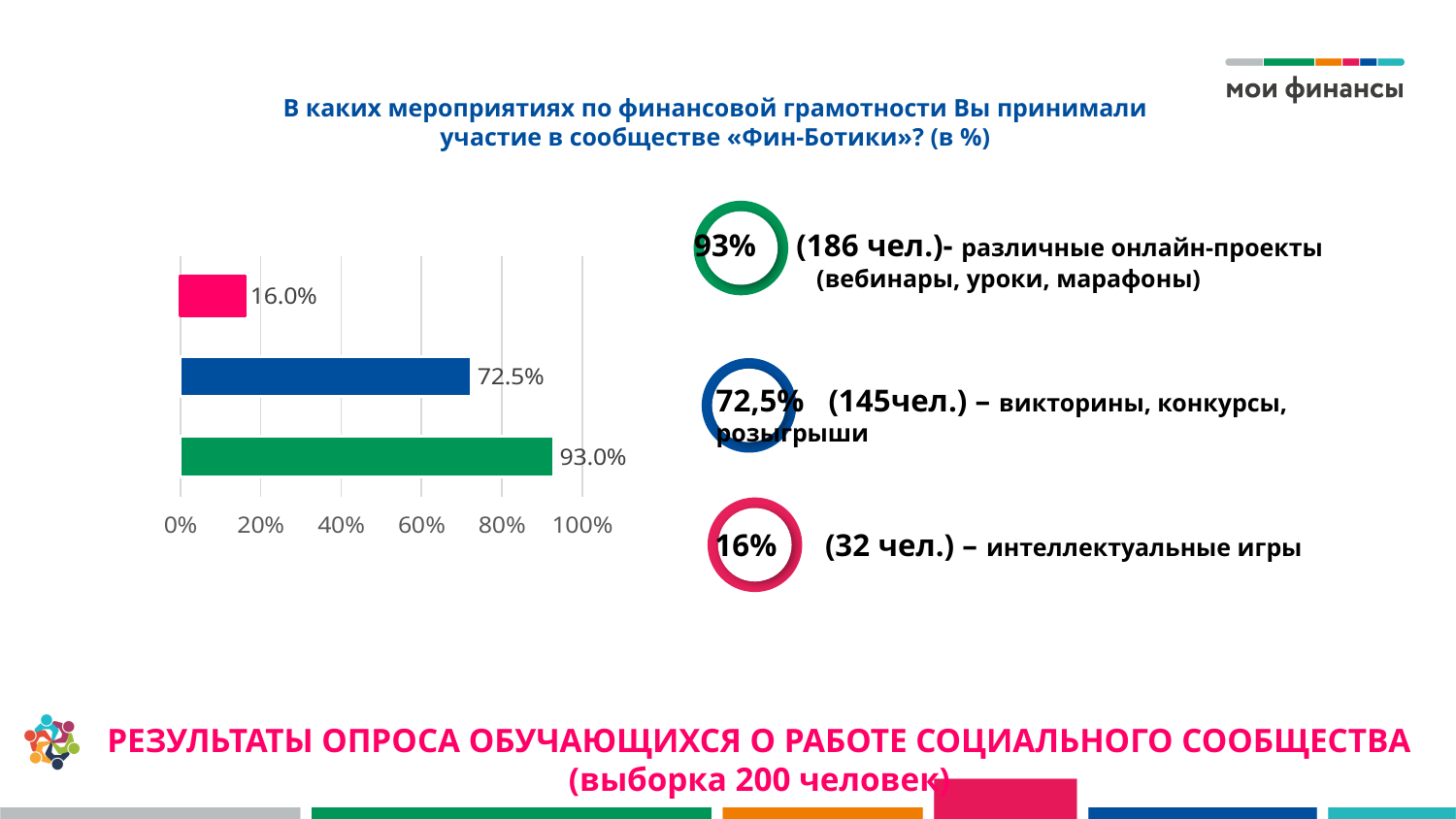
Which is larger, the value of the blue bar or the value of the pink bar? the blue bar Which bar in the chart has the highest value? the green bar (93.0%) Is the value of the blue bar greater or less than 60%? greater What is the difference between the blue bar (72.5%) and the pink bar (16.0%)? 56.5% What value is labelled on the green bar of the chart? 93.0% What kind of chart is shown on the slide? bar chart What value is labelled on the pink bar of the chart? 16.0% What is the maximum value shown on the chart's horizontal axis? 100% How many bars does the chart contain? 3 What value is labelled on the blue bar of the chart? 72.5% What is the difference between the green bar (93.0%) and the blue bar (72.5%)? 20.5% Which bar in the chart has the lowest value? the pink bar (16.0%)